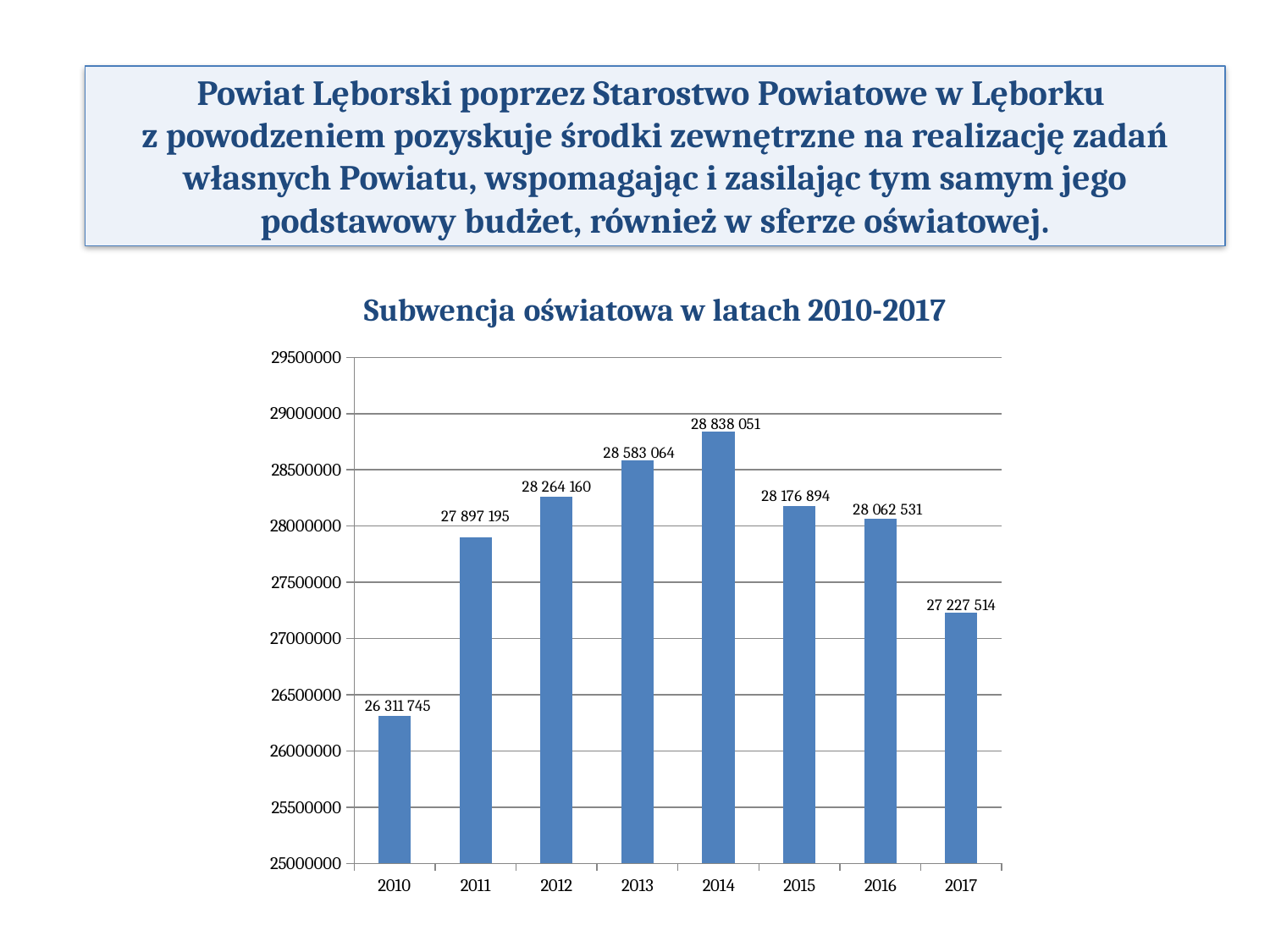
Which year has the highest value in the chart? 2014 Which is larger, the value for 2015 or the value for 2016? 2015 How many years are shown on the x axis of the chart? 8 What is the value for 2017 in the chart? 27 227 514 What is the difference between the values for 2014 and 2010? 2 526 306 Is the value for 2011 greater or less than 28000000? less What is the value for 2014 in the chart "Subwencja oświatowa w latach 2010-2017"? 28 838 051 What is the value for 2010 in the chart? 26 311 745 Do the values rise or fall from 2014 to 2017? fall What is the difference between the values for 2013 and 2012? 318 904 What kind of chart is shown on the slide? bar chart Which year has the lowest value in the chart? 2010